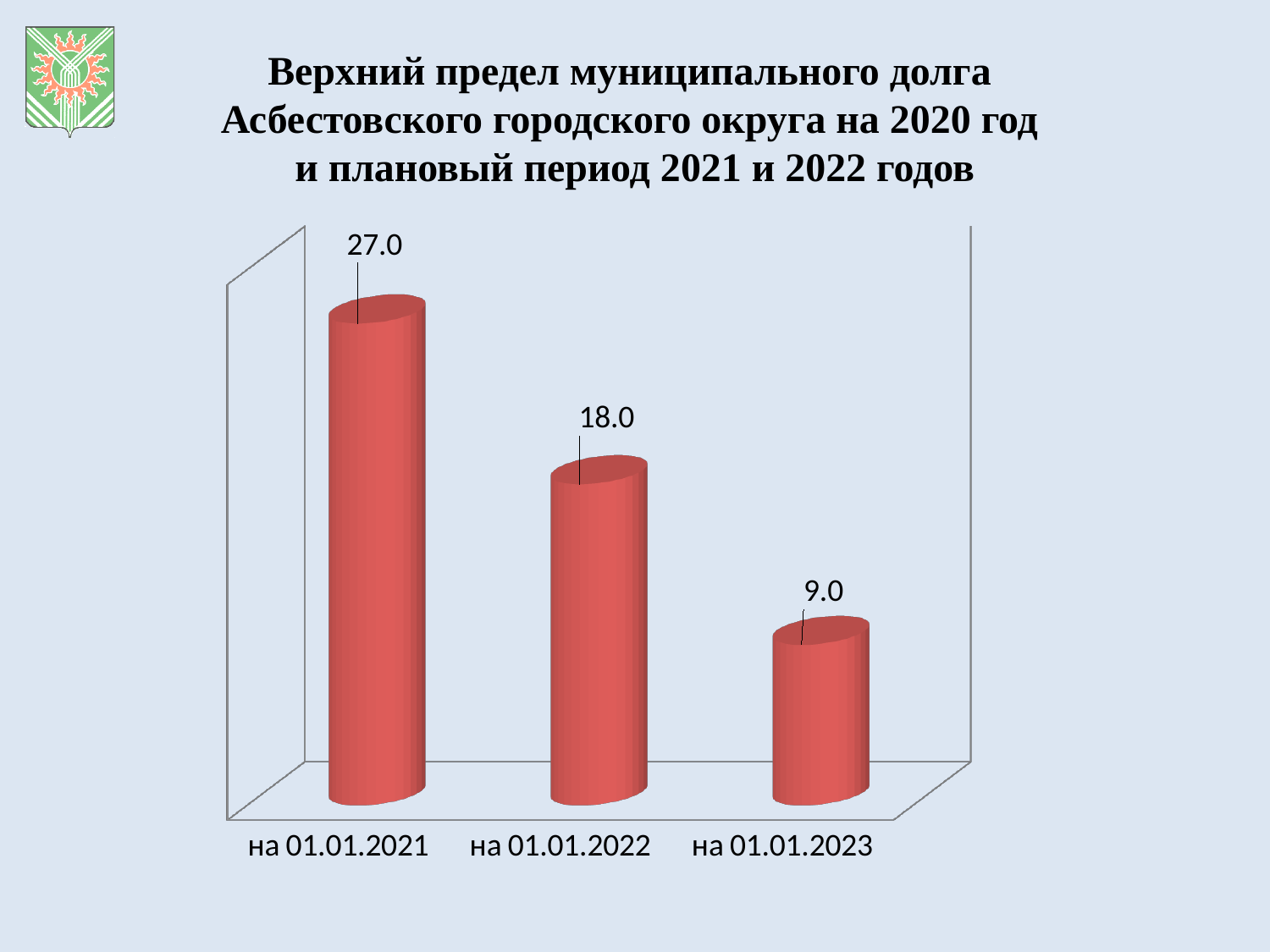
What kind of chart is shown on the slide? bar chart What is the difference between the values for на 01.01.2021 and на 01.01.2022? 9.0 Which is larger, the value for на 01.01.2022 or the value for на 01.01.2023? на 01.01.2022 What is the value for на 01.01.2023? 9.0 Do the values rise or fall from на 01.01.2021 to на 01.01.2023? fall Which category has the highest value? на 01.01.2021 What is the value for на 01.01.2021? 27.0 How many categories are shown on the chart? 3 Which category has the lowest value? на 01.01.2023 What colour are the bars on the chart? red What is the value for на 01.01.2022? 18.0 What is the difference between the values for на 01.01.2021 and на 01.01.2023? 18.0